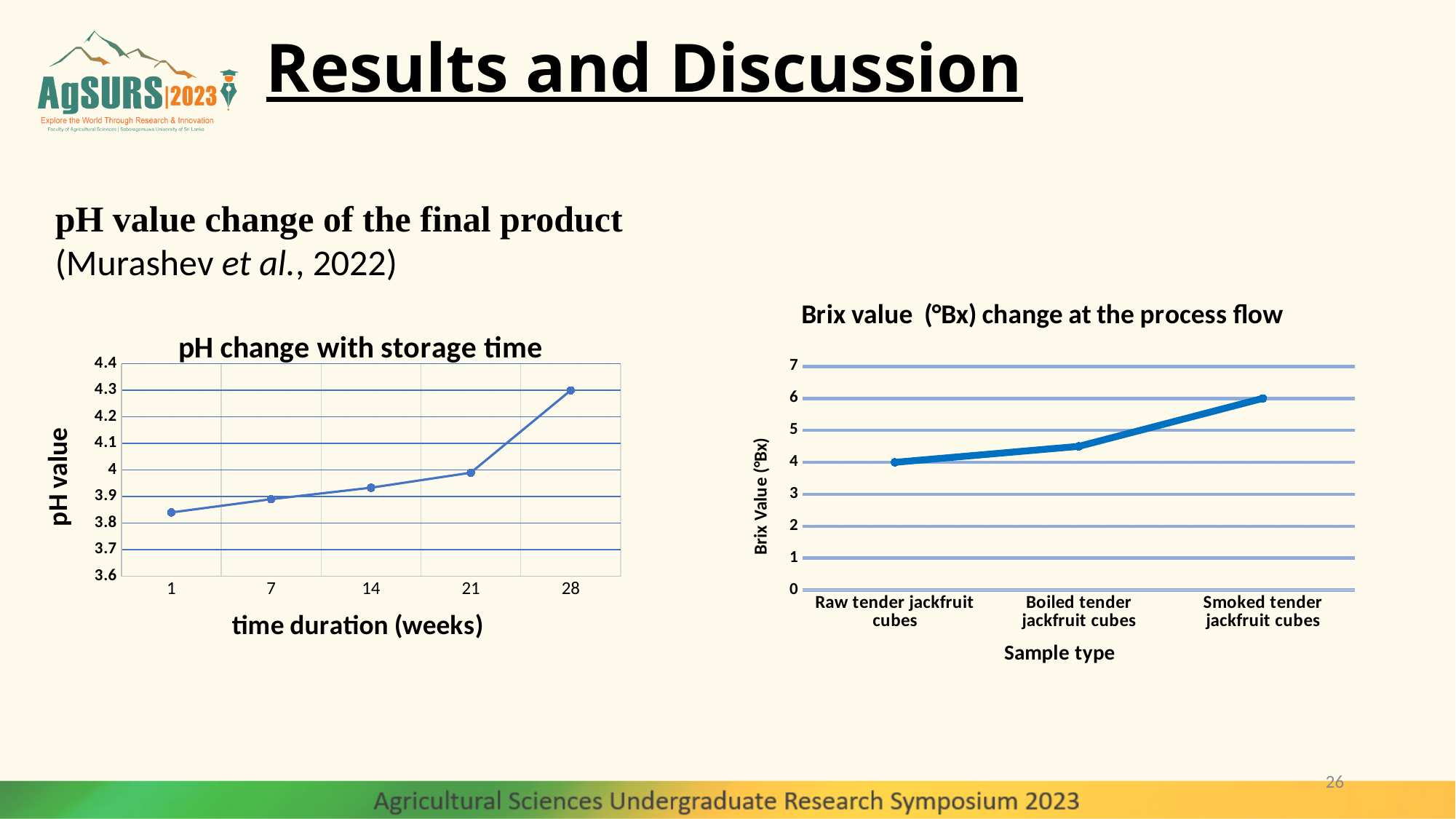
In the 'Brix value (°Bx) change at the process flow' chart, what is the Brix value for Raw tender jackfruit cubes? 4 In the 'pH change with storage time' chart, at which time duration is the pH value lowest? 1 In the 'pH change with storage time' chart, do pH values rise or fall as the time duration increases? rise In the 'pH change with storage time' chart, what is the pH value at 28 weeks? 4.3 In the 'pH change with storage time' chart, at which time duration is the pH value highest? 28 In the 'pH change with storage time' chart, is the pH value at 1 week greater or less than 3.9? less In the 'pH change with storage time' chart, how many time points are plotted? 5 In the 'Brix value (°Bx) change at the process flow' chart, is the Brix value for Boiled tender jackfruit cubes greater or less than 5? less In the 'Brix value (°Bx) change at the process flow' chart, what is the difference in Brix value between Smoked tender jackfruit cubes and Raw tender jackfruit cubes? 2 In the 'Brix value (°Bx) change at the process flow' chart, what is the Brix value for Smoked tender jackfruit cubes? 6 In the 'Brix value (°Bx) change at the process flow' chart, what is the label of the x axis? Sample type What kind of chart is the 'pH change with storage time' chart? line chart